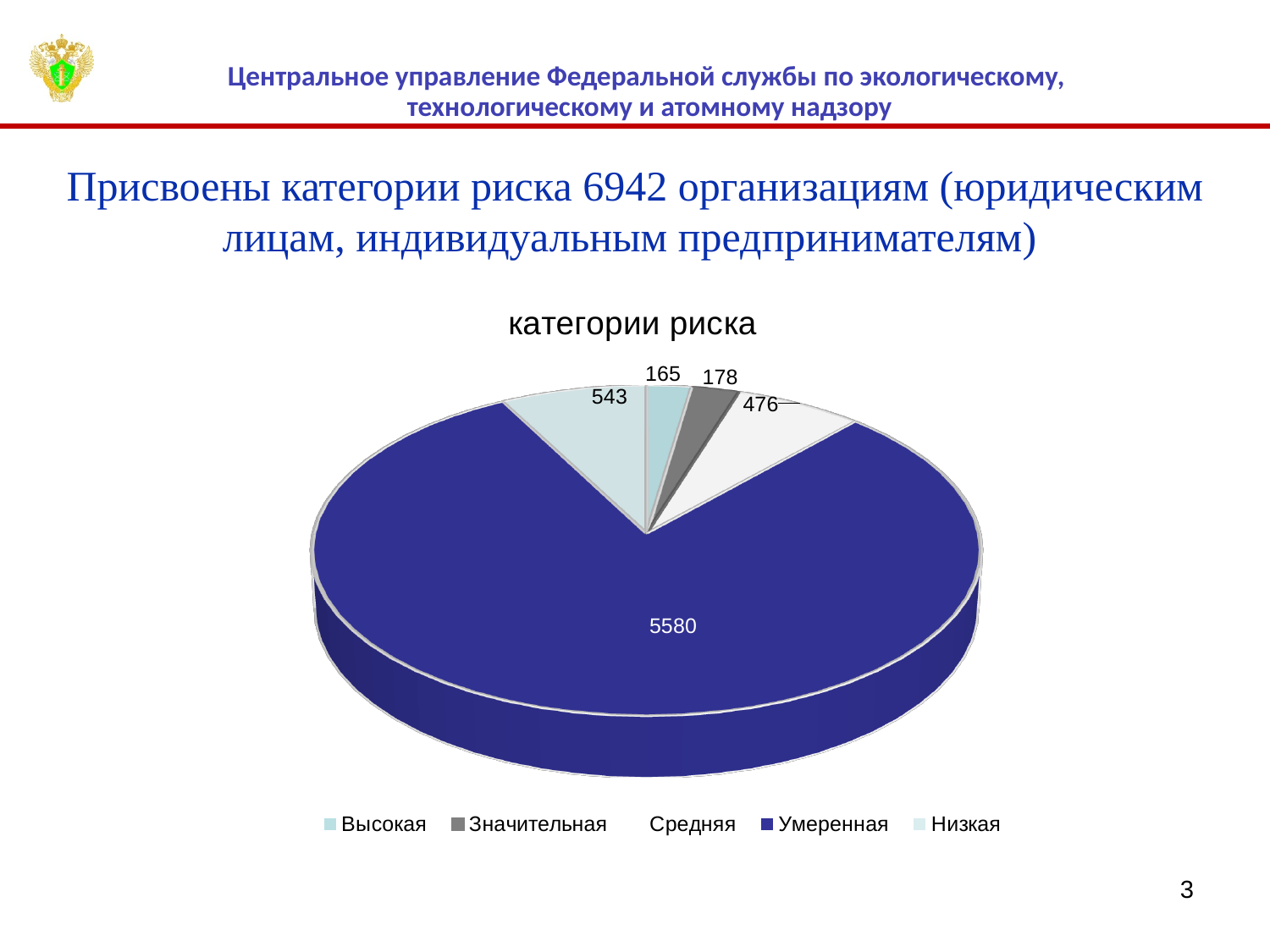
How many categories does the pie chart have? 5 What is the value for the Средняя category? 476 What is the value for the Низкая category? 543 Which category has the largest slice? Умеренная What is the total of all slices in the pie chart? 6942 What is the value for the Умеренная category? 5580 What is the title of the chart? категории риска What is the difference between the values for Низкая and Средняя? 67 Which category has the smallest slice? Высокая What kind of chart is shown on the slide? pie chart Which is larger, the value for Значительная or the value for Высокая? Значительная What is the value for the Высокая category? 165